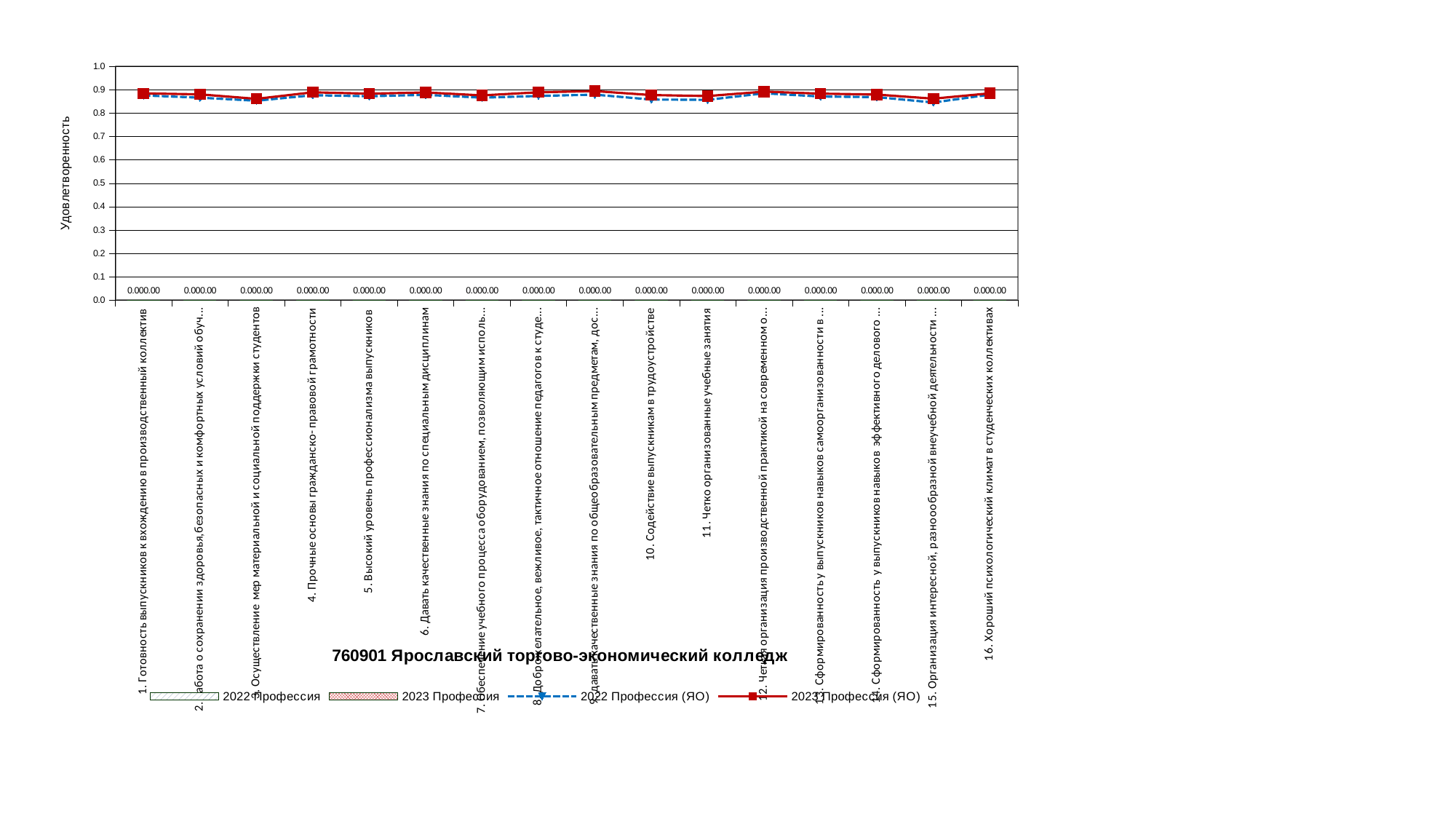
How many series does the legend list? 4 How many categories are shown along the x axis? 16 Do the values of the 2023 Профессия (ЯО) line rise, fall, or stay roughly flat across the categories? roughly flat What is the title of the chart? 760901 Ярославский торгово-экономический колледж Is the value of the 2023 Профессия (ЯО) line for category 1 (Готовность выпускников к вхождению в производственный коллектив) greater or less than 0.5? greater Is the value of the 2022 Профессия (ЯО) line for category 3 (Осуществление мер материальной и социальной поддержки студентов) greater or less than 0.6? greater What kind of chart is shown on the slide? combination bar and line chart Which series is drawn as a dashed blue line? 2022 Профессия (ЯО) Is the value of the 2023 Профессия (ЯО) line for category 10 (Содействие выпускникам в трудоустройстве) greater or less than 1.0? less Does the 2023 Профессия (ЯО) line generally lie above or below the 2022 Профессия (ЯО) line? above